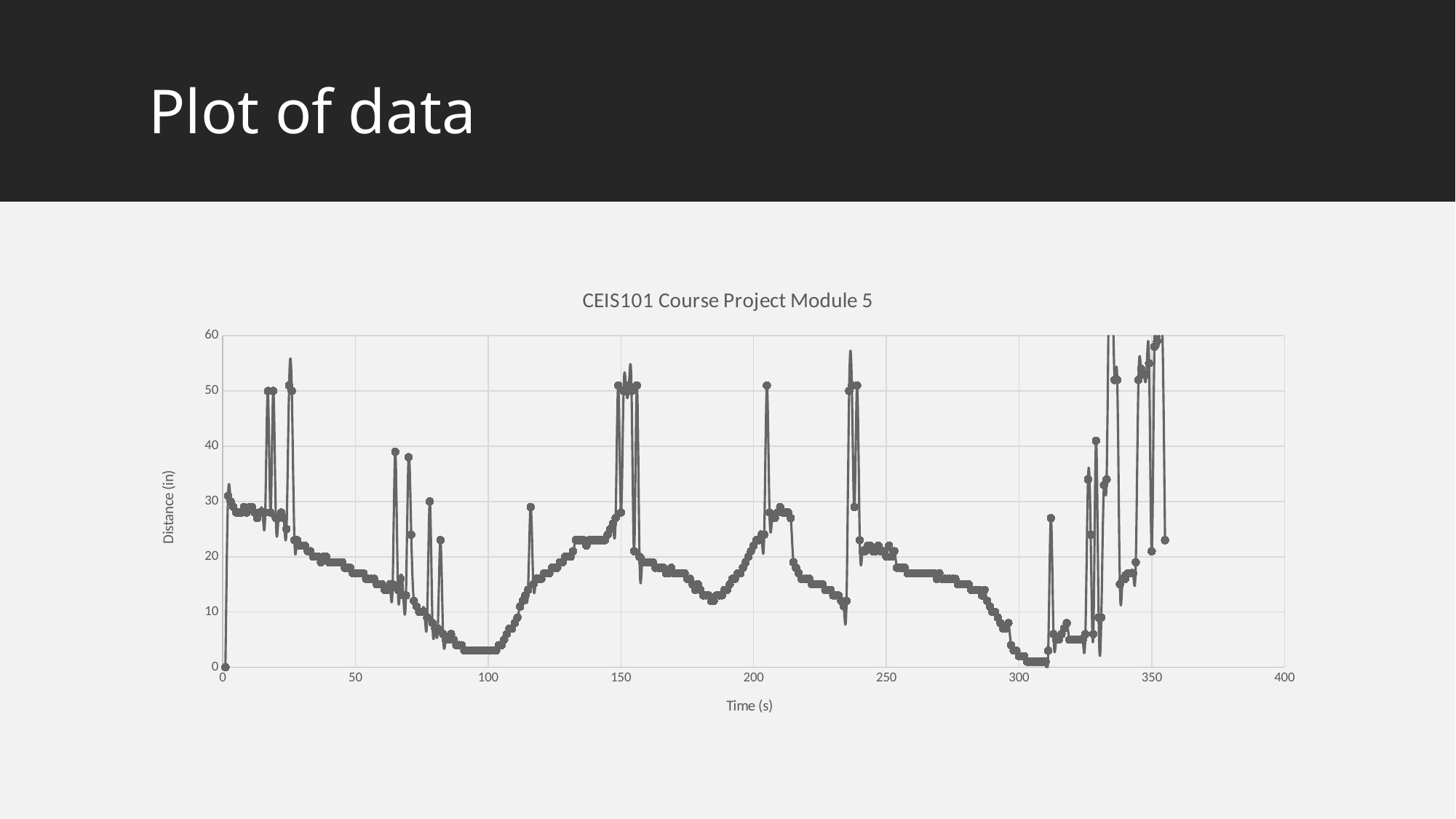
What is the title of the chart? CEIS101 Course Project Module 5 Do the distance values generally rise or fall between time 100 s and time 150 s? rise Is the distance value at time 100 s greater or less than 10? less Is the distance value at time 250 s greater or less than 10? greater Do the distance values generally rise or fall between time 30 s and time 100 s? fall What kind of chart is shown on the slide? line chart Is the distance value at time 0 s greater or less than 20? less Which is larger, the distance value at time 100 s or the distance value at time 150 s? time 150 s What is the highest value shown on the y axis? 60 What is the label of the x axis? Time (s)